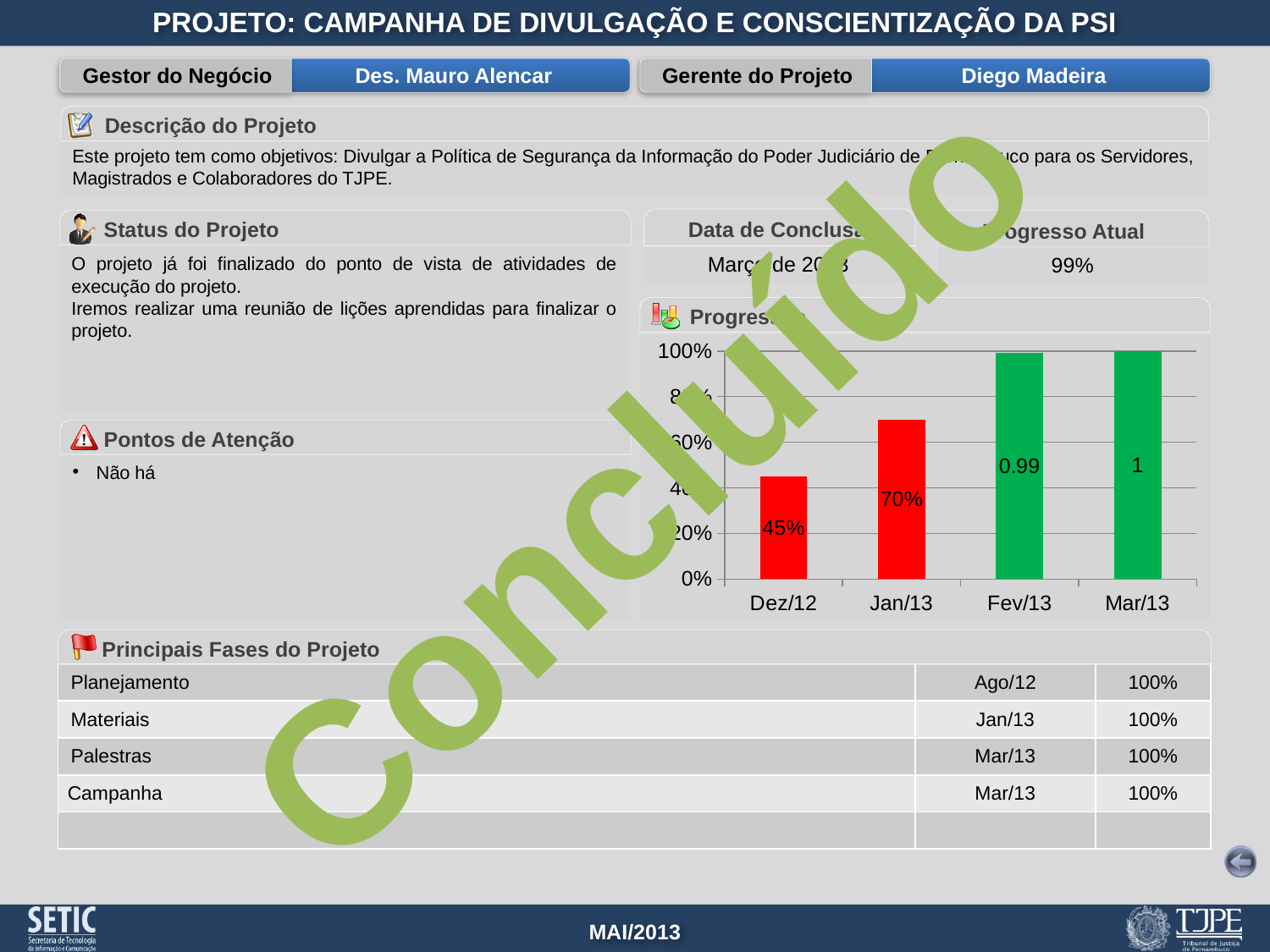
What is the difference between the Jan/13 value and the Dez/12 value? 25% What colour are the bars for Fev/13 and Mar/13? green Is the value for Dez/12 greater or less than 60%? less What is the value shown for Dez/12 in the bar chart? 45% Do the values rise or fall from Dez/12 to Mar/13? rise What is the value shown for Jan/13 in the bar chart? 70% What is the data label shown on the Fev/13 bar? 0.99 Which month has the lowest bar in the chart? Dez/12 How many months are shown on the x axis of the chart? 4 What kind of chart is shown on the slide? bar chart Which is larger, the value for Dez/12 or the value for Jan/13? Jan/13 What is the data label shown on the Mar/13 bar? 1